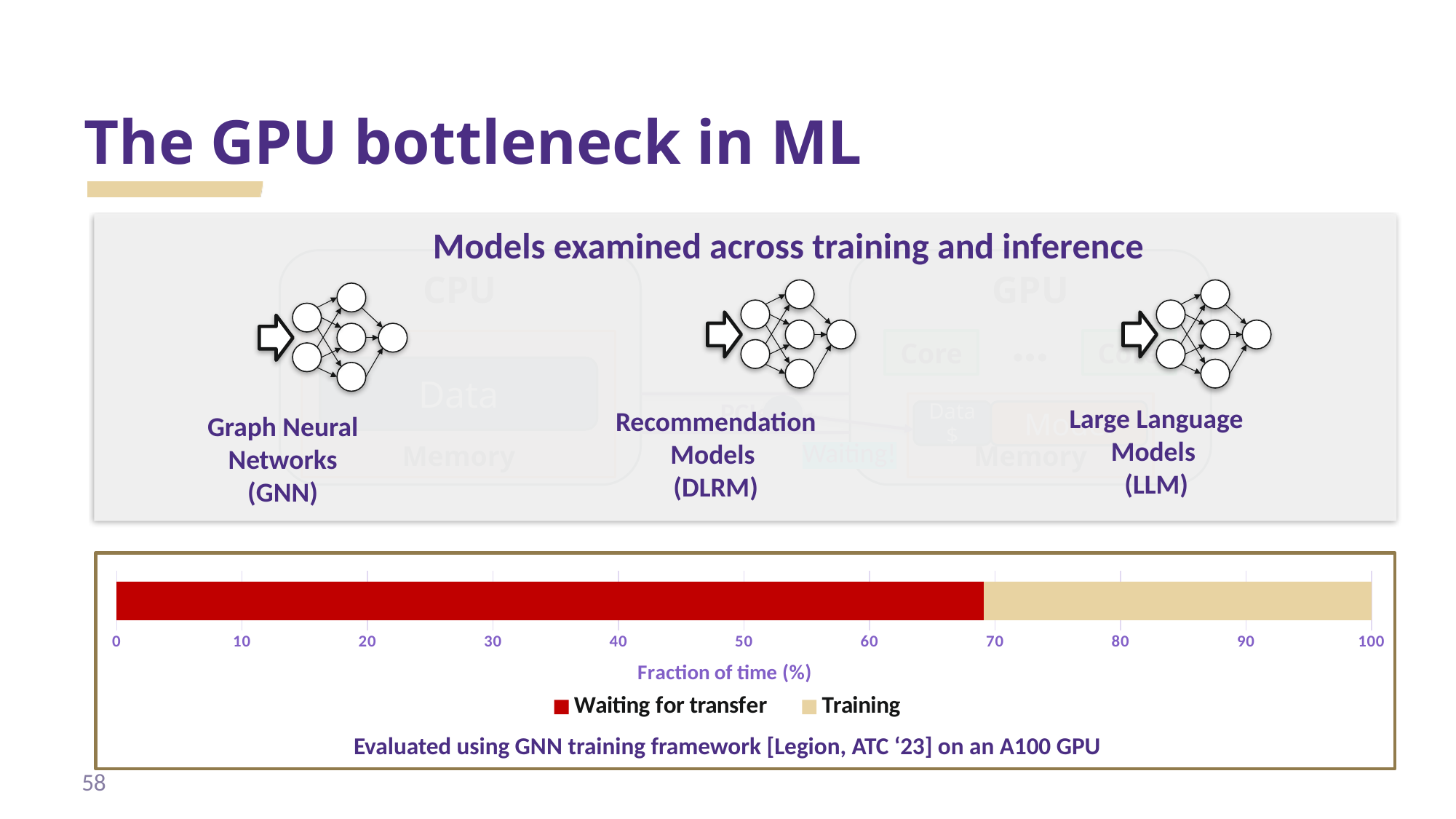
Is the value for Waiting for transfer greater or less than 50? greater How many series does the chart's legend list? 2 Is the value for Training greater or less than 20? greater What are the two series named in the chart's legend? Waiting for transfer; Training Which series takes up the larger share of the bar, Waiting for transfer or Training? Waiting for transfer Is the value for Waiting for transfer greater or less than 60? greater What is the total of the stacked bar, as read from the axis where it ends? 100 What is the title of the chart's horizontal axis? Fraction of time (%) How many bars are plotted in the chart? 1 What is the highest value shown on the chart's horizontal axis? 100 What kind of chart is shown on the slide? Stacked bar chart